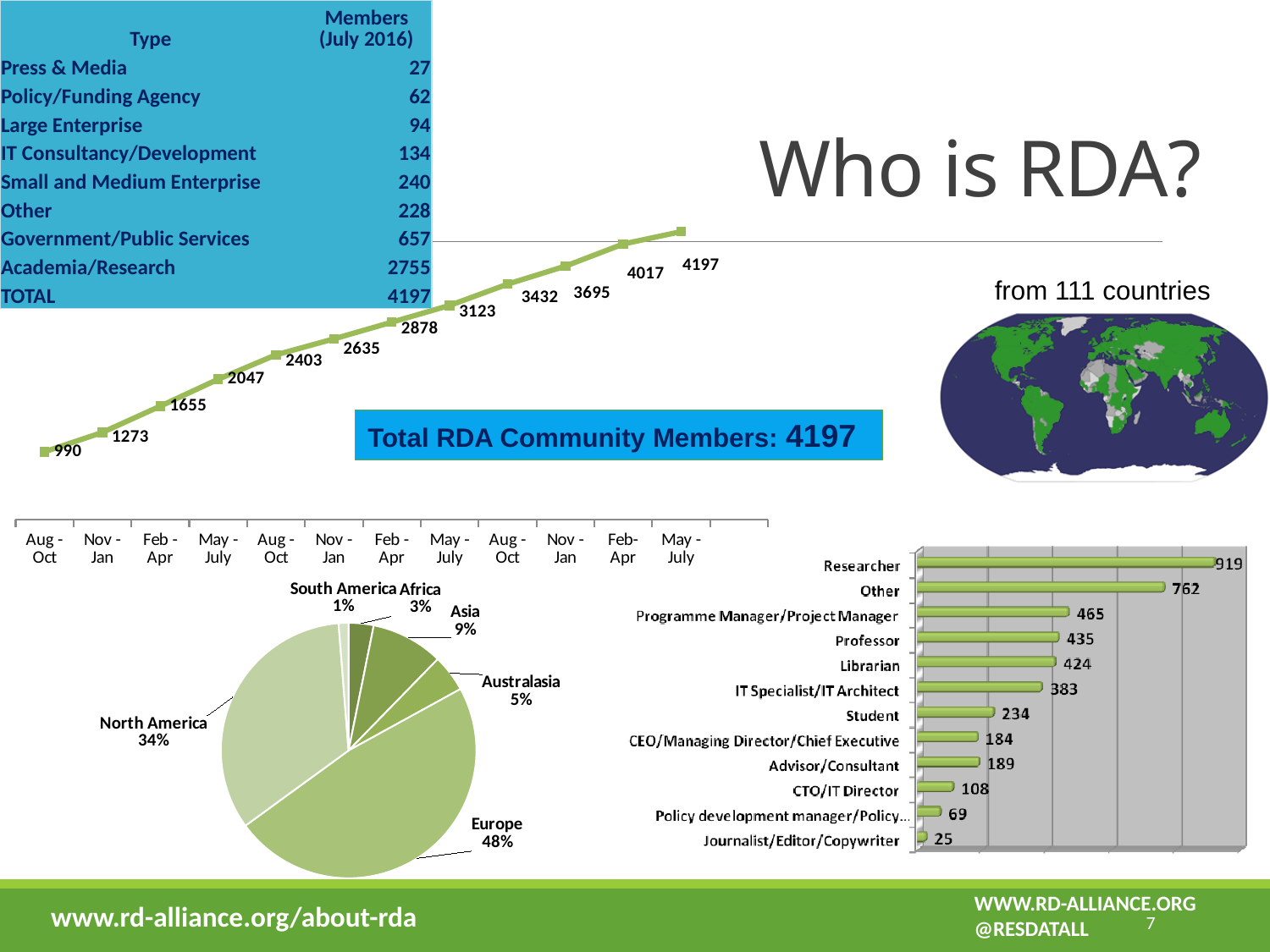
In the line chart of RDA community members over time, what is the value of the last data point (May - July)? 4197 In the line chart of RDA community members over time, what is the value of the first data point (Aug - Oct)? 990 In the line chart of RDA community members over time, do the values rise or fall along the x axis? rise How many slices does the pie chart of members by region have? 6 In the bar chart of members by role, which role has the highest value? Researcher In the pie chart of members by region, what is the difference between the shares of North America and Asia? 25% In the pie chart of members by region, what share does Europe have? 48% What kind of chart is the chart of members by role at the bottom right of the slide? bar chart How many data points are plotted in the line chart of RDA community members over time? 12 In the pie chart of members by region, which region has the smallest share? South America In the bar chart of members by role, what is the value for Librarian? 424 In the bar chart of members by role, which is larger: Advisor/Consultant or CEO/Managing Director/Chief Executive? Advisor/Consultant